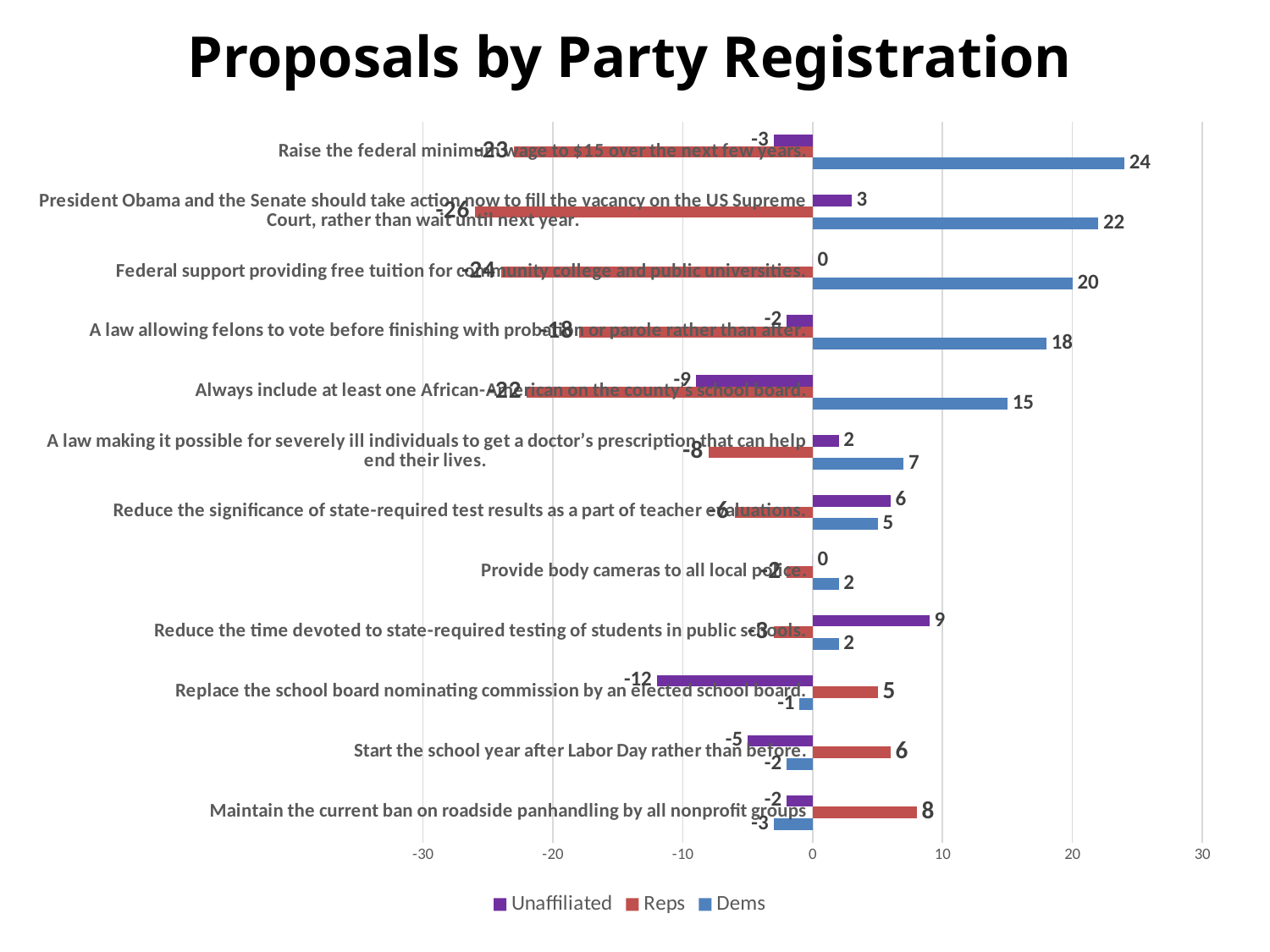
Which is larger: the Dems value for "Federal support providing free tuition for community college and public universities" or the Dems value for "Always include at least one African-American on the county's school board"? Federal support providing free tuition for community college and public universities. What is the Reps value for "Maintain the current ban on roadside panhandling by all nonprofit groups"? 8 What type of chart is shown on the slide? bar chart What is the difference between the Dems values for the federal minimum wage proposal (24) and the Supreme Court vacancy proposal (22)? 2 How many proposals (categories) are plotted on the chart? 12 Which proposal has the lowest Dems value? Maintain the current ban on roadside panhandling by all nonprofit groups Is the Reps value for "President Obama and the Senate should take action now to fill the vacancy on the US Supreme Court, rather than wait until next year" greater or less than -20? less How many series does the legend list? 3 What is the Unaffiliated value for "Reduce the time devoted to state-required testing of students in public schools"? 9 What is the Dems value for "Raise the federal minimum wage to $15 over the next few years"? 24 Which proposal has the highest Dems value? Raise the federal minimum wage to $15 over the next few years. What is the Unaffiliated value for "Replace the school board nominating commission by an elected school board"? -12